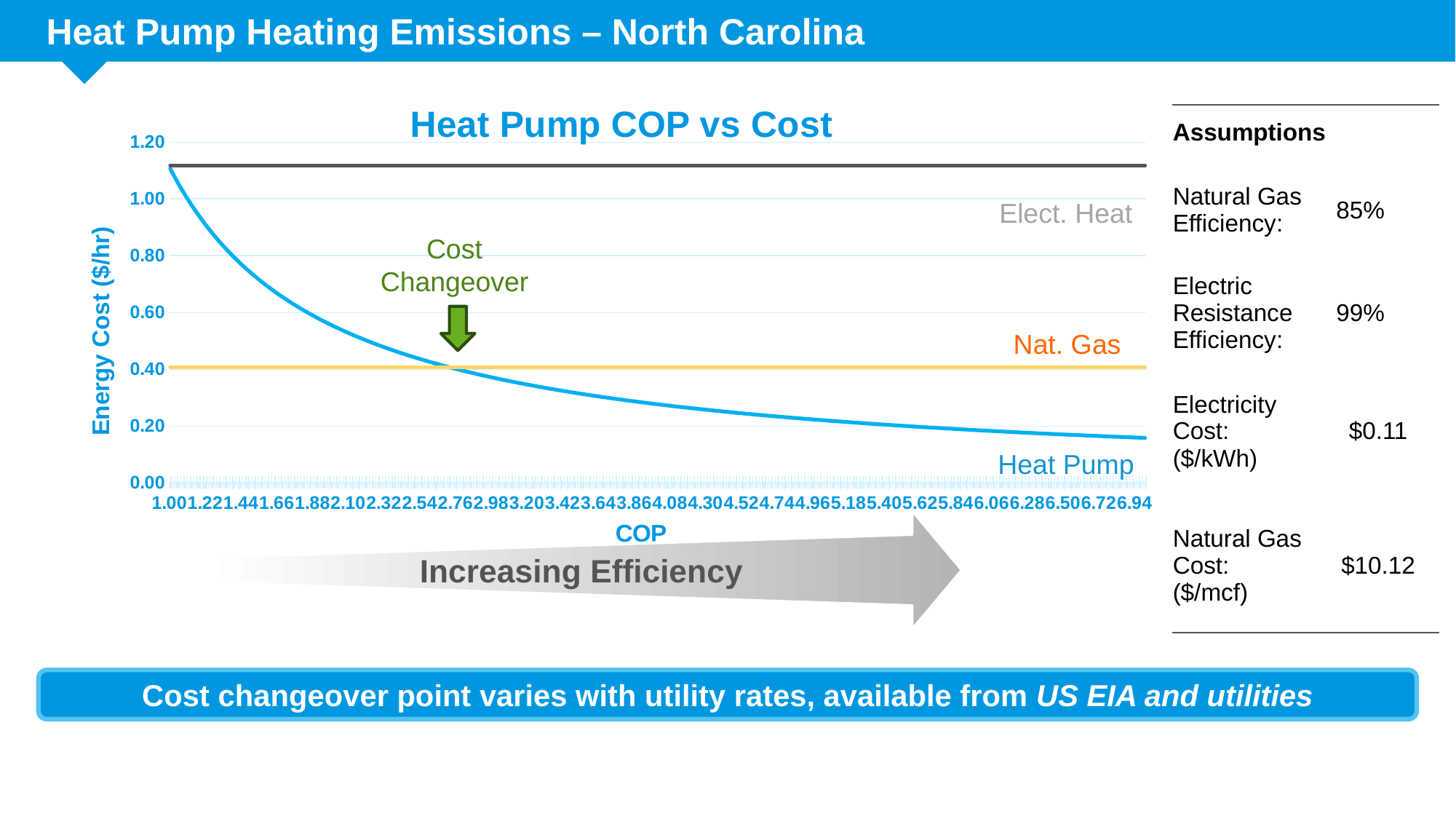
Is the Heat Pump value at COP 6.94 greater or less than 0.20? less What is the label on the vertical axis of the chart? Energy Cost ($/hr) How many series (lines) are plotted on the chart? 3 Is the value of the Nat. Gas line greater or less than 0.60? less Is the Heat Pump value at COP 1.00 greater or less than 0.80? greater Which of the three lines has the lowest energy cost at COP 6.94? Heat Pump What kind of chart is shown on the slide? Line chart What is the title of the chart? Heat Pump COP vs Cost At COP 1.00, which is higher, the Heat Pump cost or the Nat. Gas cost? Heat Pump Which line has the higher energy cost, Elect. Heat or Nat. Gas? Elect. Heat Does the Heat Pump line rise or fall as COP increases along the x axis? Fall